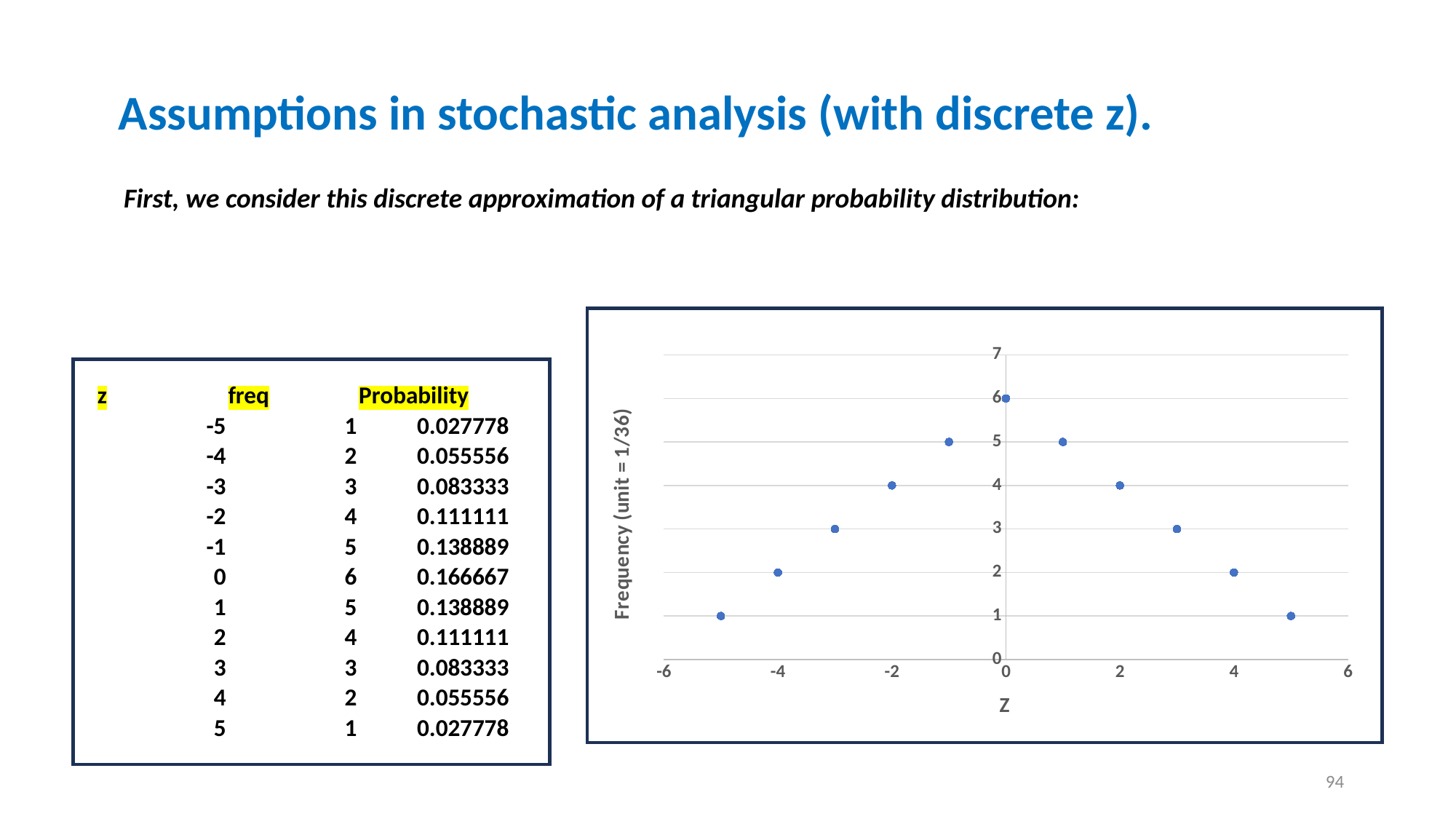
What is the frequency plotted at z = 0? 6 Which has a larger frequency, z = -2 or z = 4? z = -2 At which value of z is the plotted frequency highest? 0 What is the label of the vertical axis of the chart? Frequency (unit = 1/36) Do the plotted frequencies rise or fall as z increases from -5 to 0? rise What is the difference between the frequency at z = 0 and the frequency at z = 5? 5 How many data points are plotted in the chart? 11 What kind of chart is shown on the slide? scatter chart What is the label of the horizontal axis of the chart? Z What is the frequency plotted at z = -5? 1 What is the frequency plotted at z = 3? 3 Do the plotted frequencies rise or fall as z increases from 0 to 5? fall